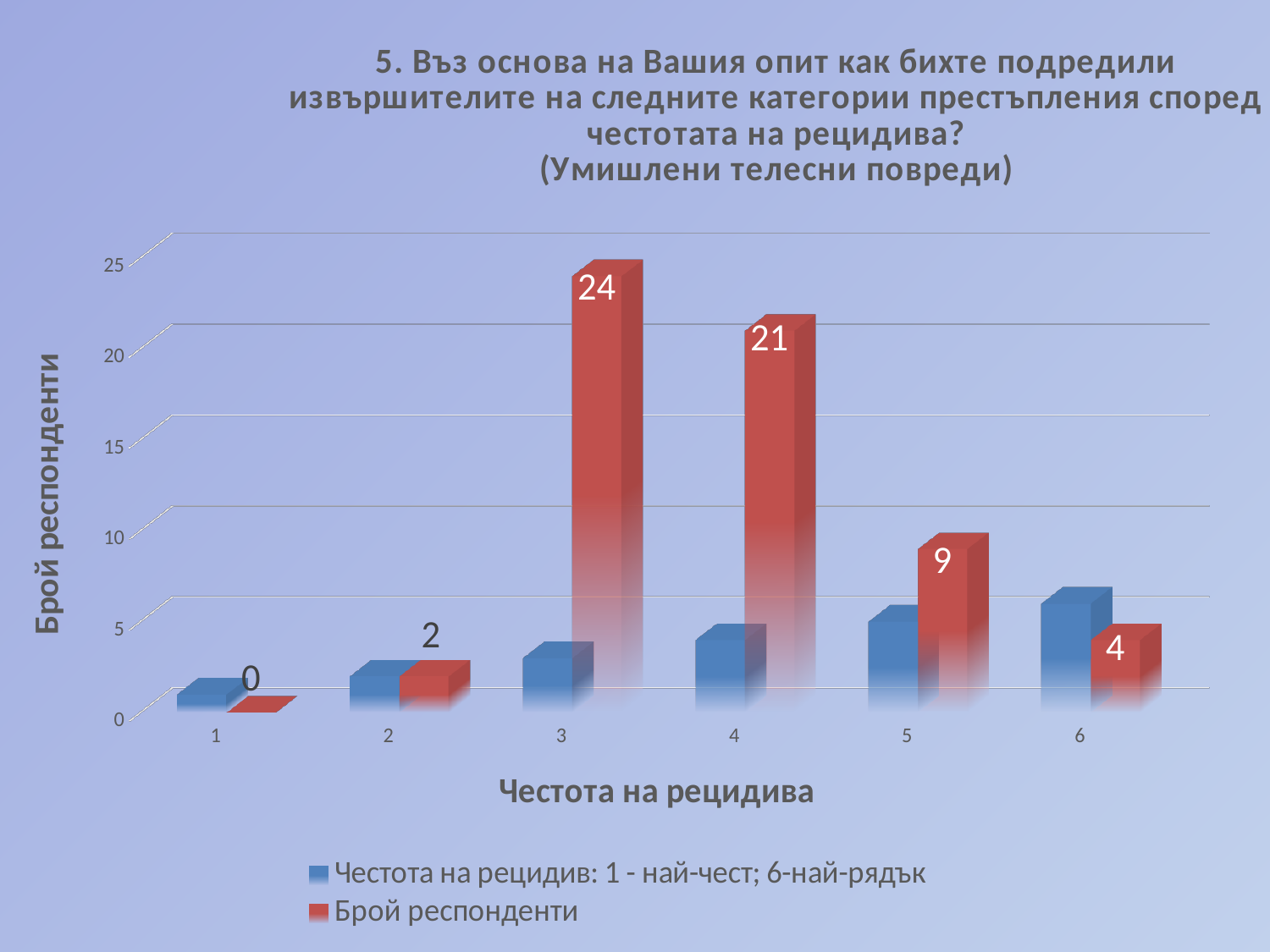
Which is larger, the Брой респонденти value for category 5 or for category 6? category 5 What is the value of Брой респонденти for category 3? 24 What kind of chart is shown on the slide? bar chart Which category has the highest value for Брой респонденти? 3 Is the blue bar for category 1 greater or less than 5? less Which category has the lowest value for Брой респонденти? 1 What is the value of Брой респонденти for category 1? 0 How many categories are shown on the x axis? 6 What is the value of Брой респонденти for category 5? 9 What is the value of Брой респонденти for category 4? 21 What is the difference between the Брой респонденти values for categories 3 and 4? 3 How many series does the legend list? 2